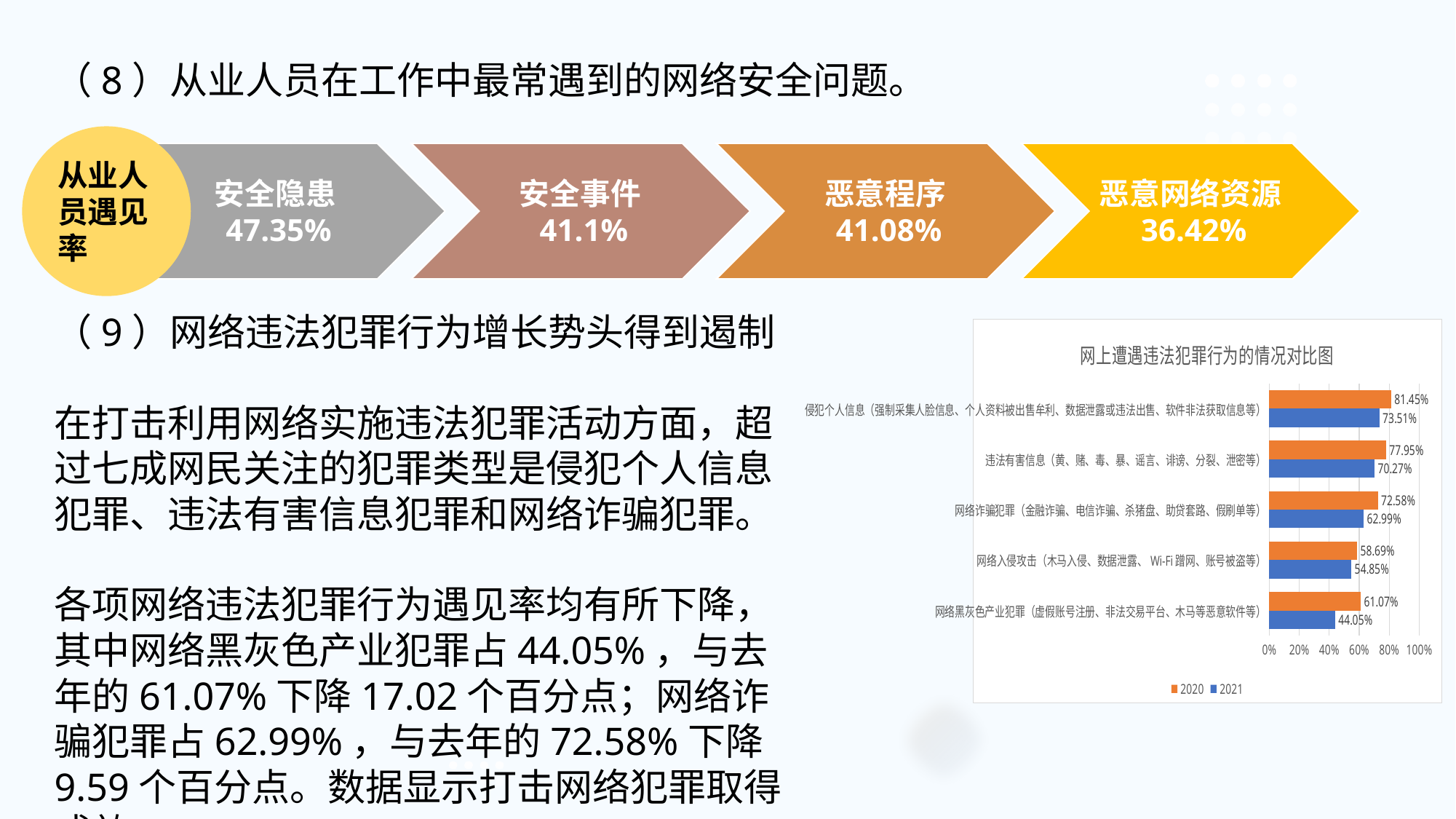
Which category has the lowest 2021 value in the chart? 网络黑灰色产业犯罪 What is the 2021 value for 网络诈骗犯罪 in the chart? 62.99% Which colour represents the 2021 series in the chart? blue What type of chart is shown on the slide? bar chart What is the 2021 value for 网络黑灰色产业犯罪 in the chart? 44.05% What is the title of the chart on the slide? 网上遭遇违法犯罪行为的情况对比图 Which category has the highest 2020 value in the chart? 侵犯个人信息 How many categories are plotted in the chart? 5 What is the 2020 value for 侵犯个人信息 in the chart? 81.45% In the chart, is the 2020 value for 网络入侵攻击 larger or the 2020 value for 网络黑灰色产业犯罪? 网络黑灰色产业犯罪 What is the difference between the 2020 and 2021 values for 网络黑灰色产业犯罪 in the chart? 17.02% How many series does the chart's legend list? 2